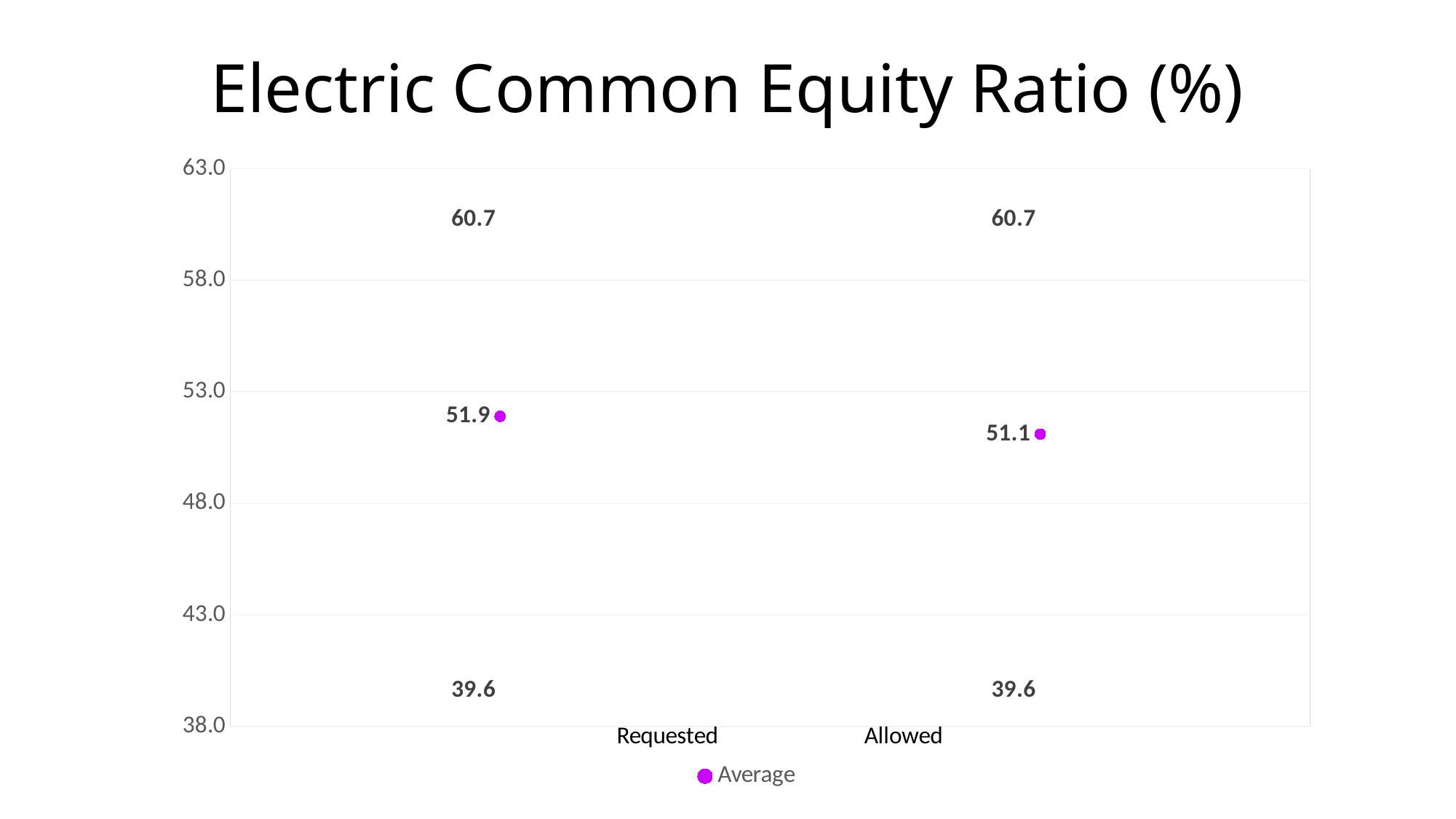
What is the difference between the Average values for Requested and Allowed? 0.8 What is the Average value for Requested? 51.9 Does the Average value rise or fall from Requested to Allowed? fall What is the Average value for Allowed? 51.1 Is the Average value for Requested greater or less than 53.0? less Is the Average value for Allowed greater or less than 48.0? greater What series name is shown in the legend? Average How many series does the legend list? 1 How many categories are shown on the x axis? 2 Which category has the lowest Average value? Allowed Which category has the higher Average value, Requested or Allowed? Requested What is the title of the chart? Electric Common Equity Ratio (%)